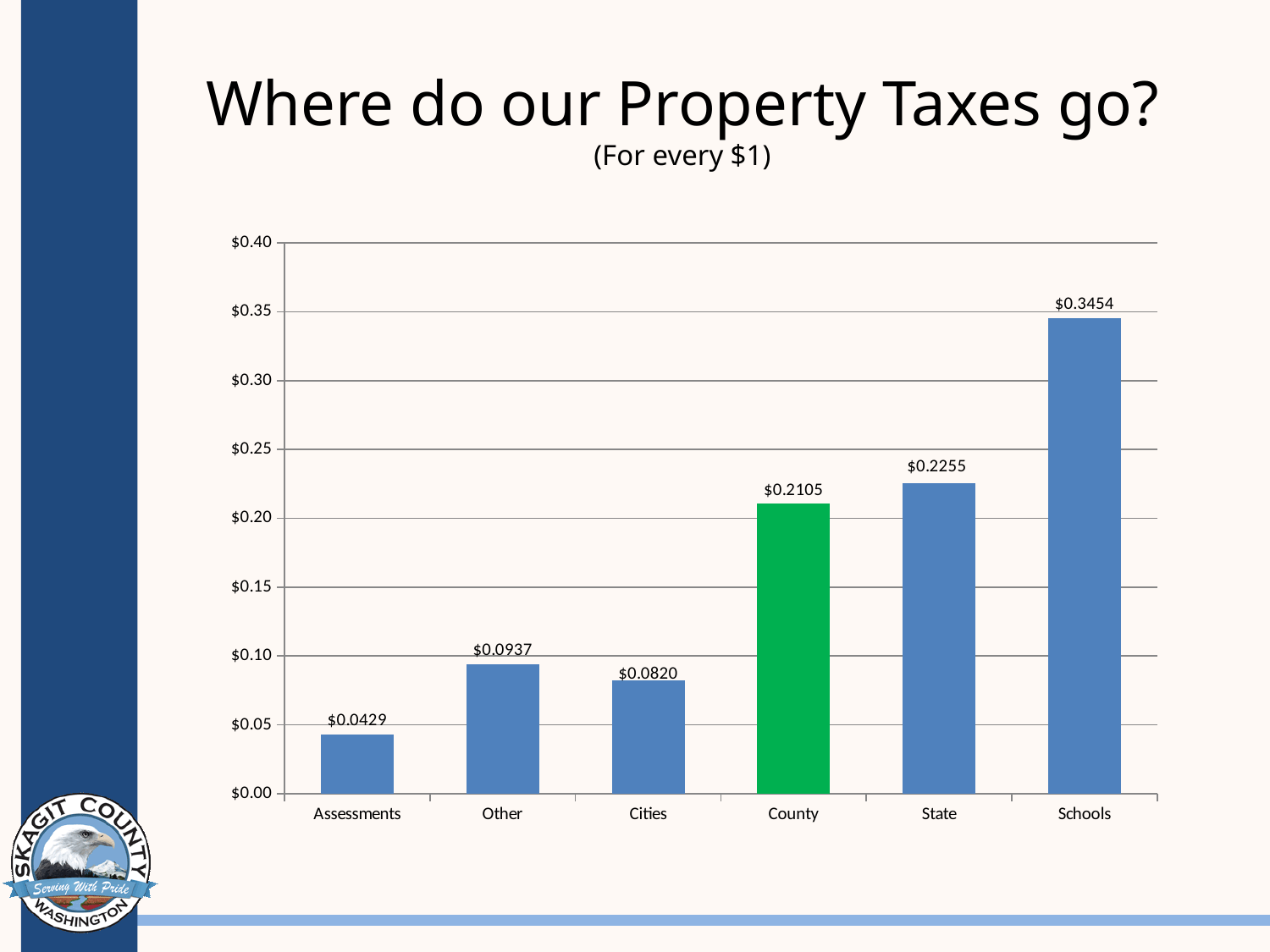
Which category has the lowest value? Assessments How many categories are shown on the x axis? 6 What is the value for Assessments? $0.0429 Is the value for Cities greater or less than $0.10? less Which is larger, the value for State or the value for County? State What is the value for Schools? $0.3454 What kind of chart is shown on the slide? bar chart What is the difference between the values for Other and Cities? $0.0117 Which category has the highest value? Schools Which bar is coloured green rather than blue? County What is the difference between the values for Schools and State? $0.1199 What is the value for County? $0.2105